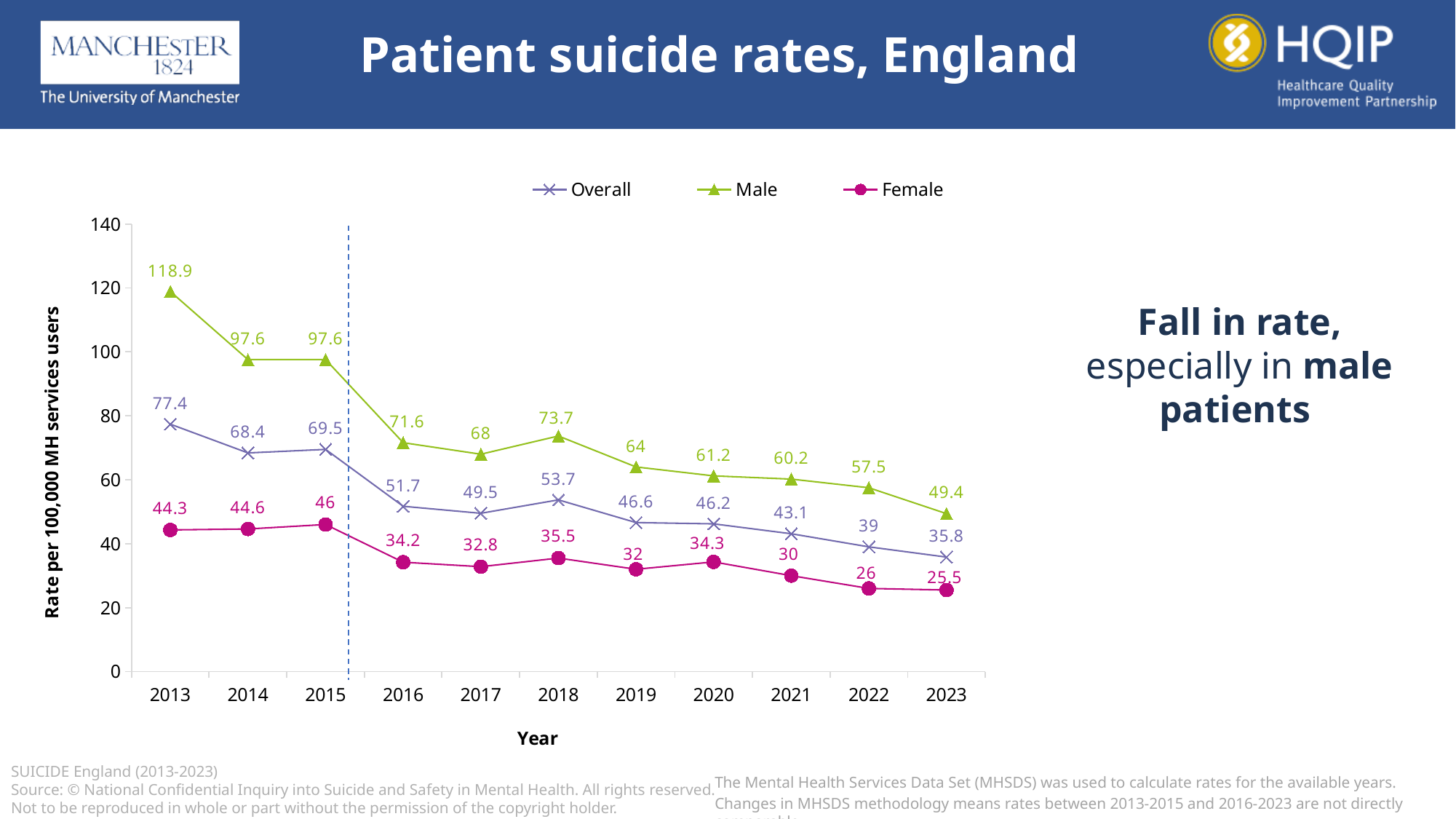
Is the Male rate in 2016 greater or less than 80? less What kind of chart is shown? line chart How many years are shown on the x axis? 11 Which is larger, the Overall rate in 2016 or the Overall rate in 2017? 2016 In which year is the Female rate lowest? 2023 What is the difference between the Male rate in 2013 and the Male rate in 2023? 69.5 What is the Overall rate in 2018? 53.7 Does the Overall rate generally rise or fall from 2013 to 2023? fall How many series does the legend list? 3 What is the Male rate in 2013? 118.9 What is the Female rate in 2023? 25.5 In which year is the Male rate highest? 2013